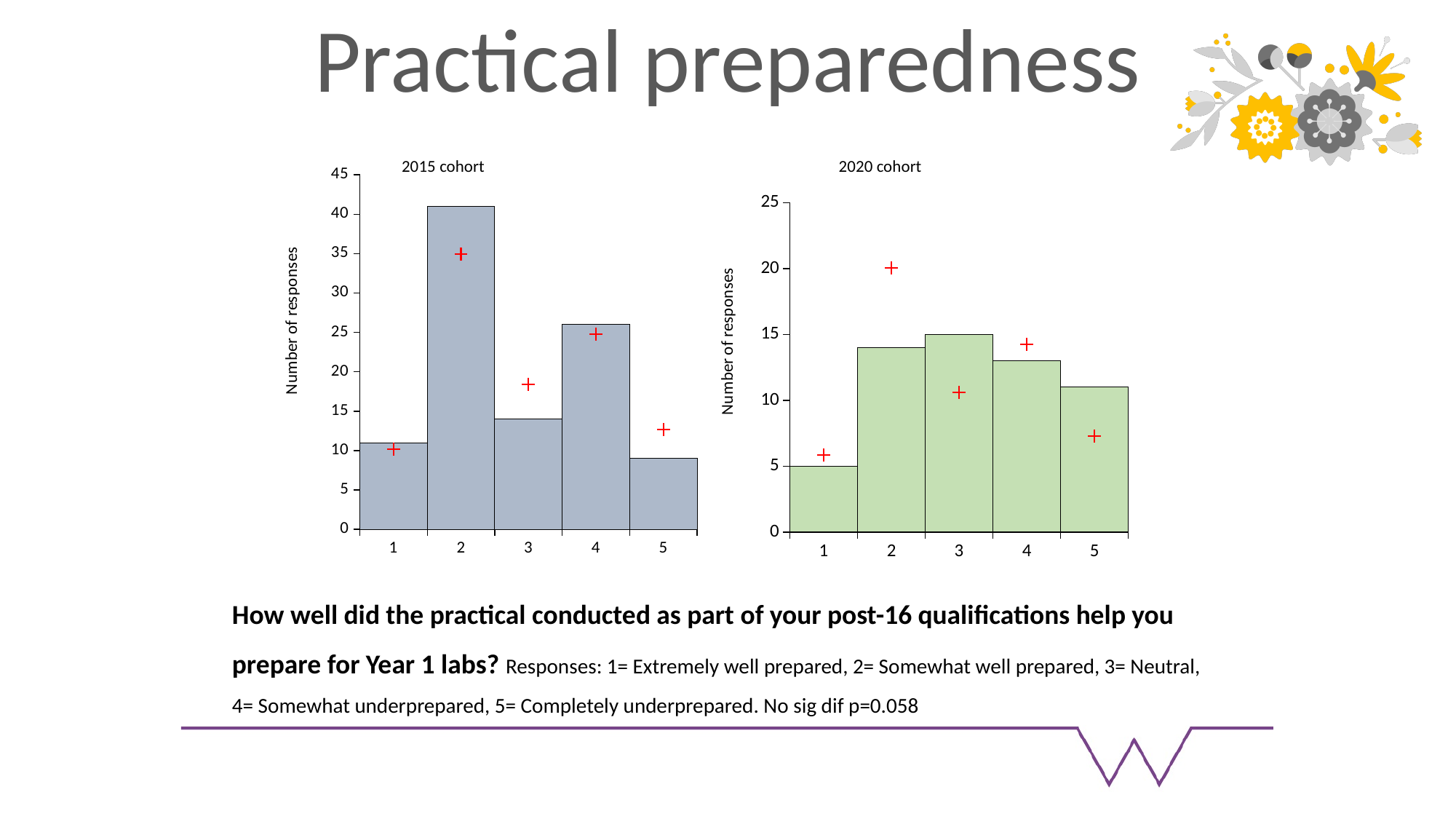
In the 2020 cohort chart, which response category has the lowest number of responses? 1 In the 2015 cohort chart, which is larger, the value for category 3 or the value for category 4? category 4 In the 2020 cohort chart, what is the number of responses for category 1? 5 In the 2015 cohort chart, is the value for category 4 greater or less than 25? greater In the 2020 cohort chart, is the value for category 5 greater or less than 10? greater What type of chart is the 2015 cohort chart? bar chart In the 2015 cohort chart, which response category has the lowest number of responses? 5 In the 2020 cohort chart, what is the number of responses for category 3? 15 In the 2015 cohort chart, which response category has the highest number of responses? 2 In the 2015 cohort chart, is the value for category 5 greater or less than 10? less How many response categories are shown on the x axis of the 2020 cohort chart? 5